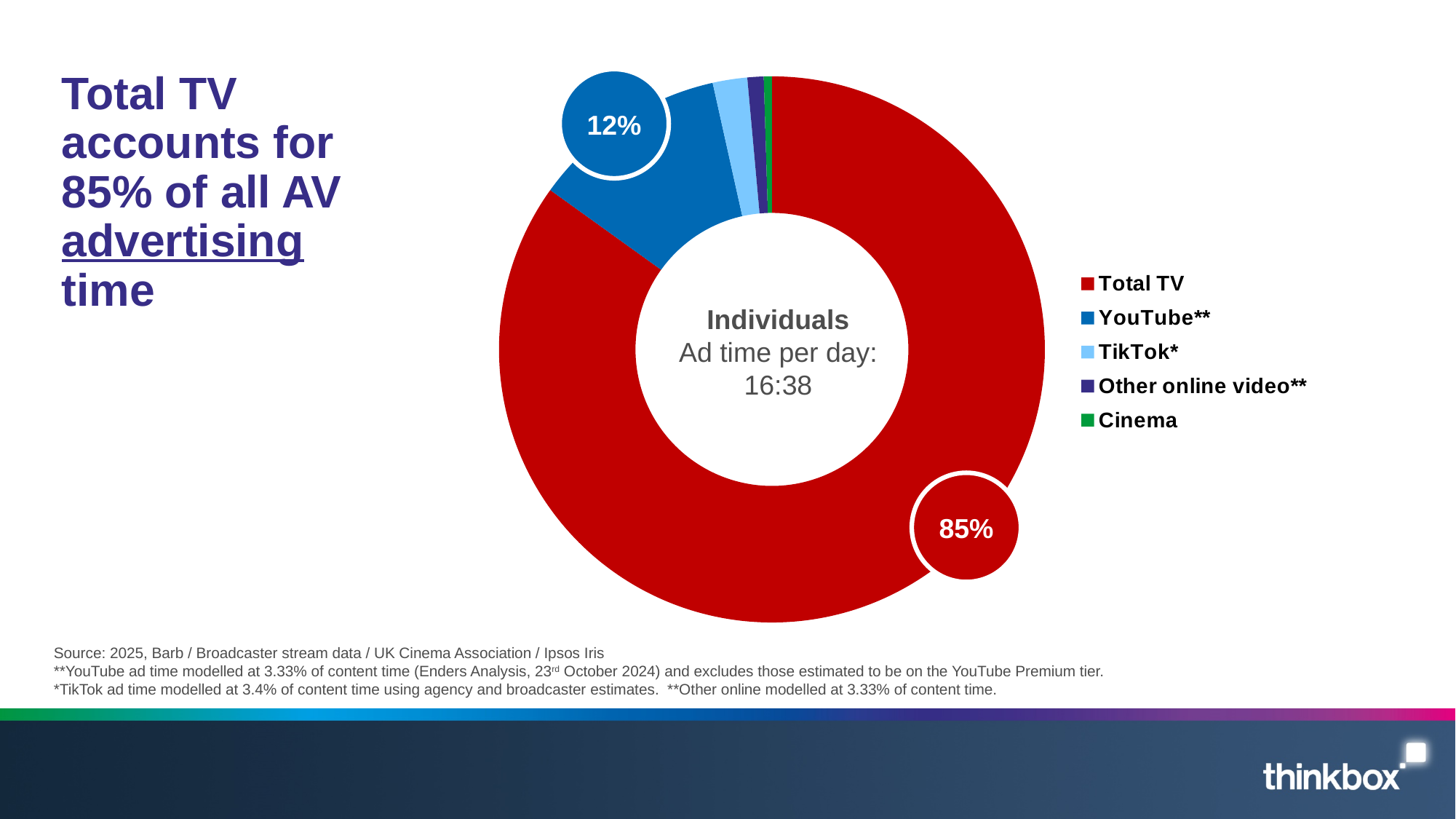
Which category has the smallest slice in the doughnut chart? Cinema Which category has the largest slice in the doughnut chart? Total TV Which colour represents Total TV in the doughnut chart? Red Which slice is larger, YouTube** or TikTok*? YouTube** Which slice is larger, Total TV or YouTube**? Total TV Is the Total TV slice greater or less than 50% of the doughnut chart? greater What ad time per day is shown in the centre of the doughnut chart? 16:38 How many categories does the legend of the doughnut chart list? 5 What share of AV advertising time does Total TV account for in the doughnut chart? 85% What share of AV advertising time does YouTube** account for in the doughnut chart? 12% What is the difference in percentage points between the Total TV and YouTube** slices? 73 percentage points What kind of chart is shown on the slide? Doughnut (pie) chart